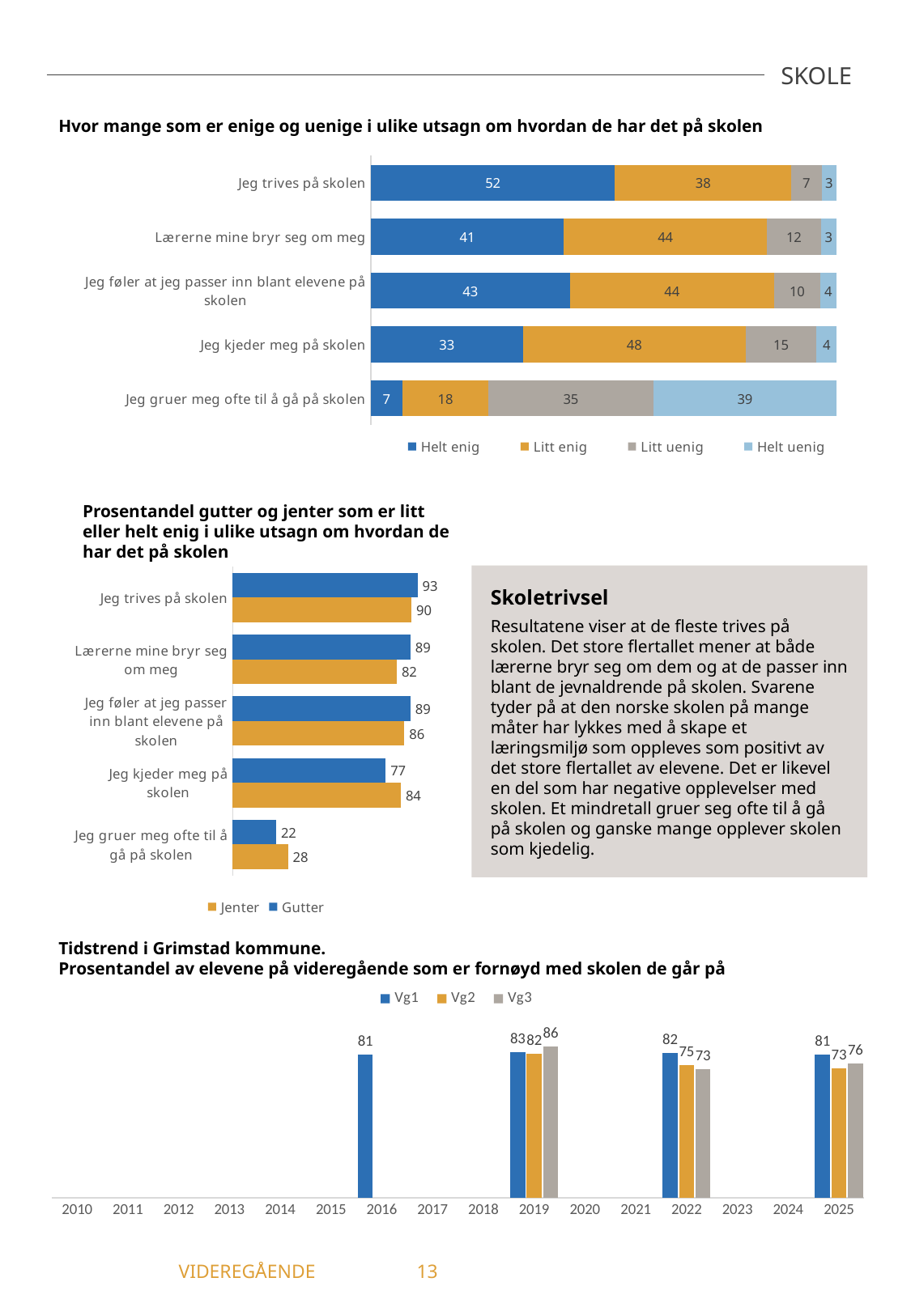
In the chart 'Hvor mange som er enige og uenige i ulike utsagn om hvordan de har det på skolen', which statement has the highest 'Litt enig' value? Jeg kjeder meg på skolen In the chart 'Hvor mange som er enige og uenige i ulike utsagn om hvordan de har det på skolen', what is the 'Helt enig' value for 'Jeg trives på skolen'? 52 In the chart 'Prosentandel gutter og jenter som er litt eller helt enig i ulike utsagn om hvordan de har det på skolen', what is the value for Jenter for 'Jeg kjeder meg på skolen'? 84 In the chart 'Tidstrend i Grimstad kommune', what is the Vg3 value for 2019? 86 In the chart 'Prosentandel gutter og jenter som er litt eller helt enig i ulike utsagn om hvordan de har det på skolen', how many statements are shown? 5 What kind of chart is 'Tidstrend i Grimstad kommune'? Bar chart In the chart 'Hvor mange som er enige og uenige i ulike utsagn om hvordan de har det på skolen', what is the 'Helt uenig' value for 'Jeg gruer meg ofte til å gå på skolen'? 39 In the chart 'Prosentandel gutter og jenter som er litt eller helt enig i ulike utsagn om hvordan de har det på skolen', which is larger for 'Lærerne mine bryr seg om meg': Gutter or Jenter? Gutter In the chart 'Tidstrend i Grimstad kommune', what is the difference between the Vg1 and Vg2 values for 2025? 8 In the chart 'Hvor mange som er enige og uenige i ulike utsagn om hvordan de har det på skolen', what is the difference between the 'Helt enig' values for 'Jeg trives på skolen' and 'Lærerne mine bryr seg om meg'? 11 In the chart 'Hvor mange som er enige og uenige i ulike utsagn om hvordan de har det på skolen', how many series does the legend list? 4 In the chart 'Prosentandel gutter og jenter som er litt eller helt enig i ulike utsagn om hvordan de har det på skolen', which statement has the lowest value for Gutter? Jeg gruer meg ofte til å gå på skolen